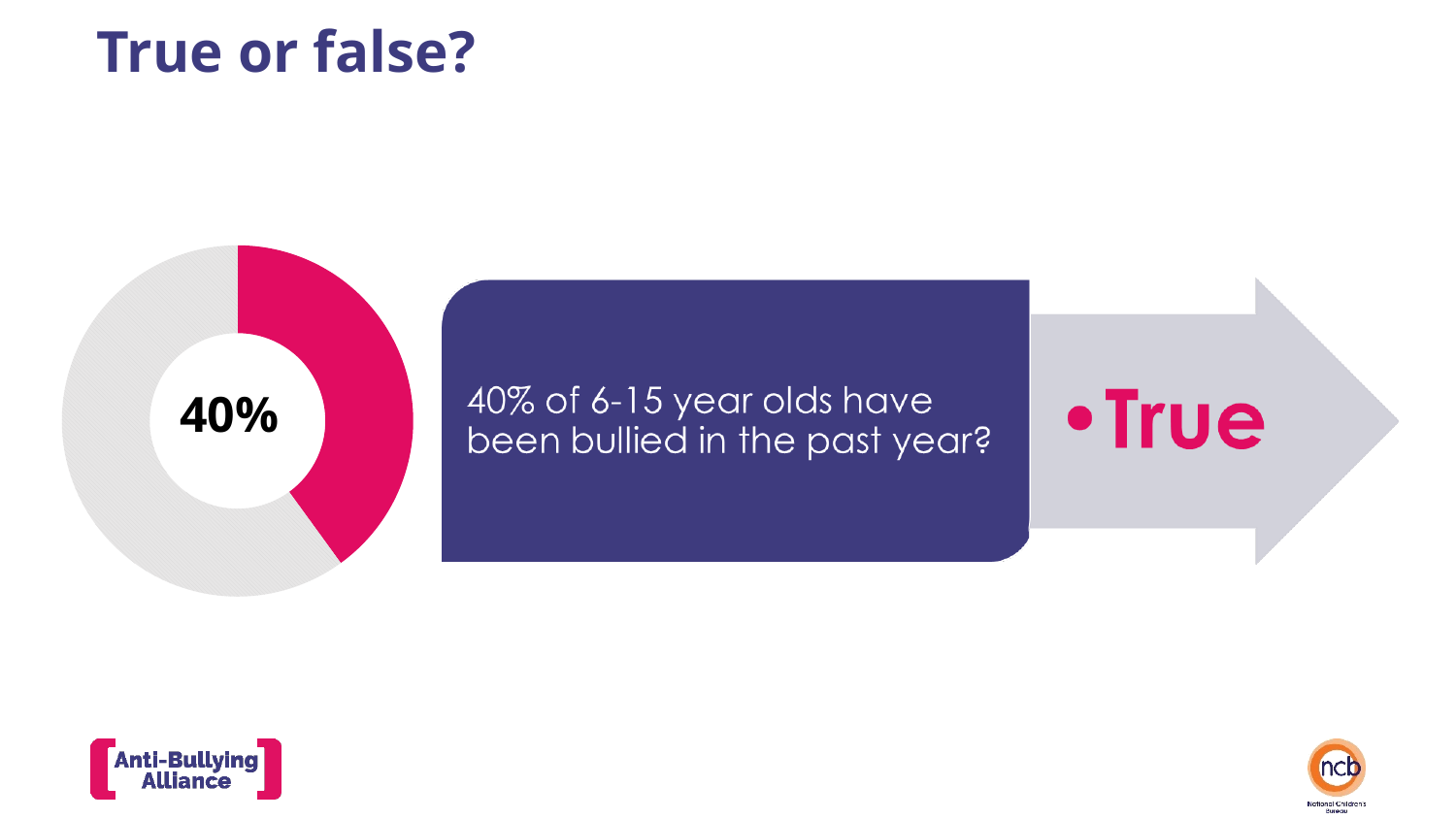
Is the pink slice of the donut chart greater or less than 50% of the whole? less How many slices does the donut chart have? 2 What share of the donut chart is the grey slice, given the pink slice is 40%? 60% Which slice of the donut chart is larger, the pink slice or the grey slice? The grey slice What share of the donut chart does the pink slice represent? 40% What percentage is printed in the centre of the donut chart? 40% What statistic does the donut chart illustrate, according to the text beside it? 40% of 6-15 year olds have been bullied in the past year What colour is the slice representing the 40% in the donut chart? Pink What kind of chart is shown on the left of the slide? Pie chart (donut)